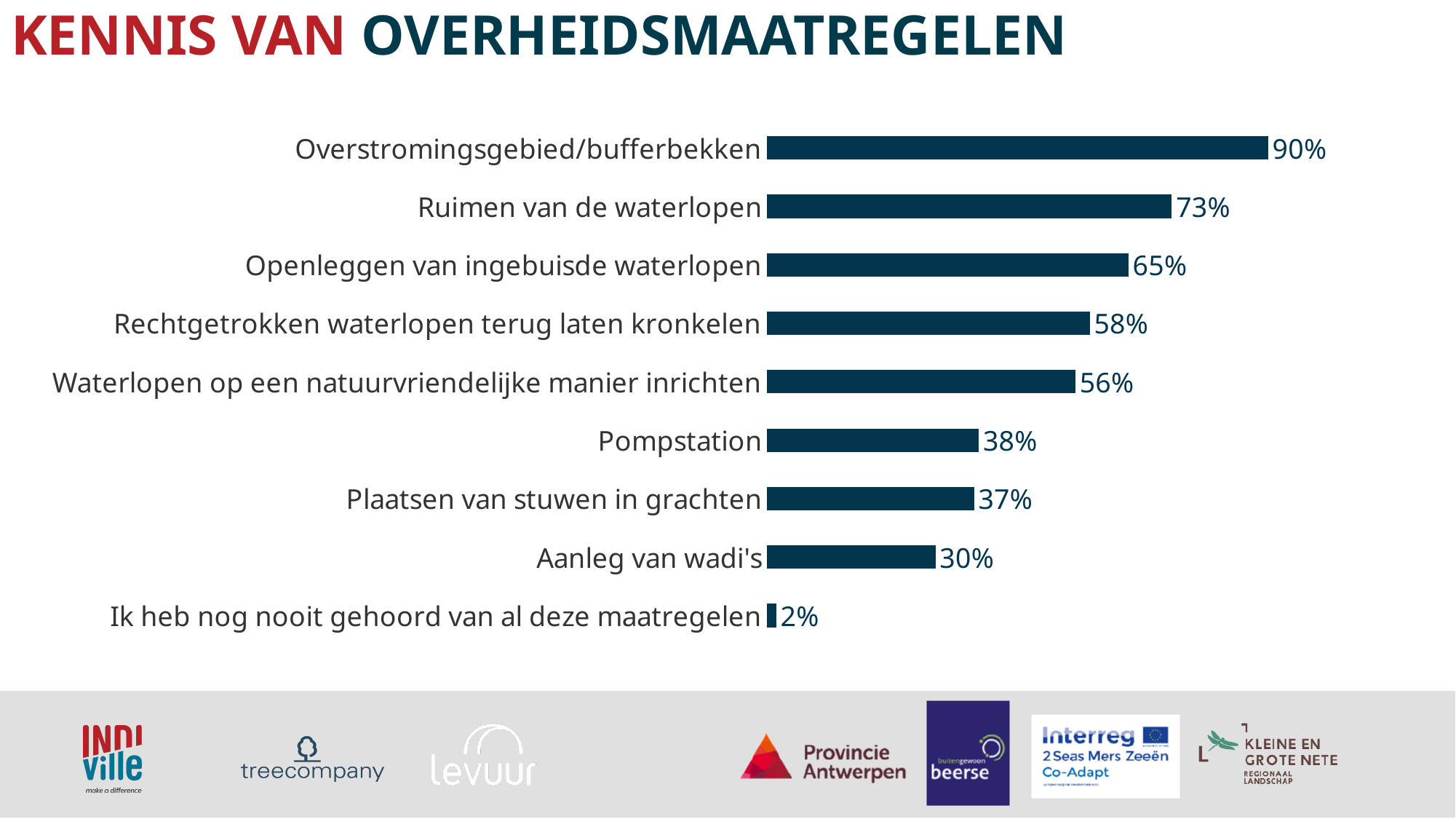
What is the difference between the values for Ruimen van de waterlopen and Openleggen van ingebuisde waterlopen? 8% What is the value for Pompstation? 38% What is the value for Overstromingsgebied/bufferbekken? 90% What is the value for Aanleg van wadi's? 30% What is the title of the slide? KENNIS VAN OVERHEIDSMAATREGELEN What is the value for Ik heb nog nooit gehoord van al deze maatregelen? 2% What is the difference between the values for Overstromingsgebied/bufferbekken and Aanleg van wadi's? 60% Which category has the highest value? Overstromingsgebied/bufferbekken What kind of chart is shown on the slide? Bar chart Which category has the lowest value? Ik heb nog nooit gehoord van al deze maatregelen How many categories are shown in the chart? 9 Which is larger: the value for Rechtgetrokken waterlopen terug laten kronkelen or the value for Pompstation? Rechtgetrokken waterlopen terug laten kronkelen